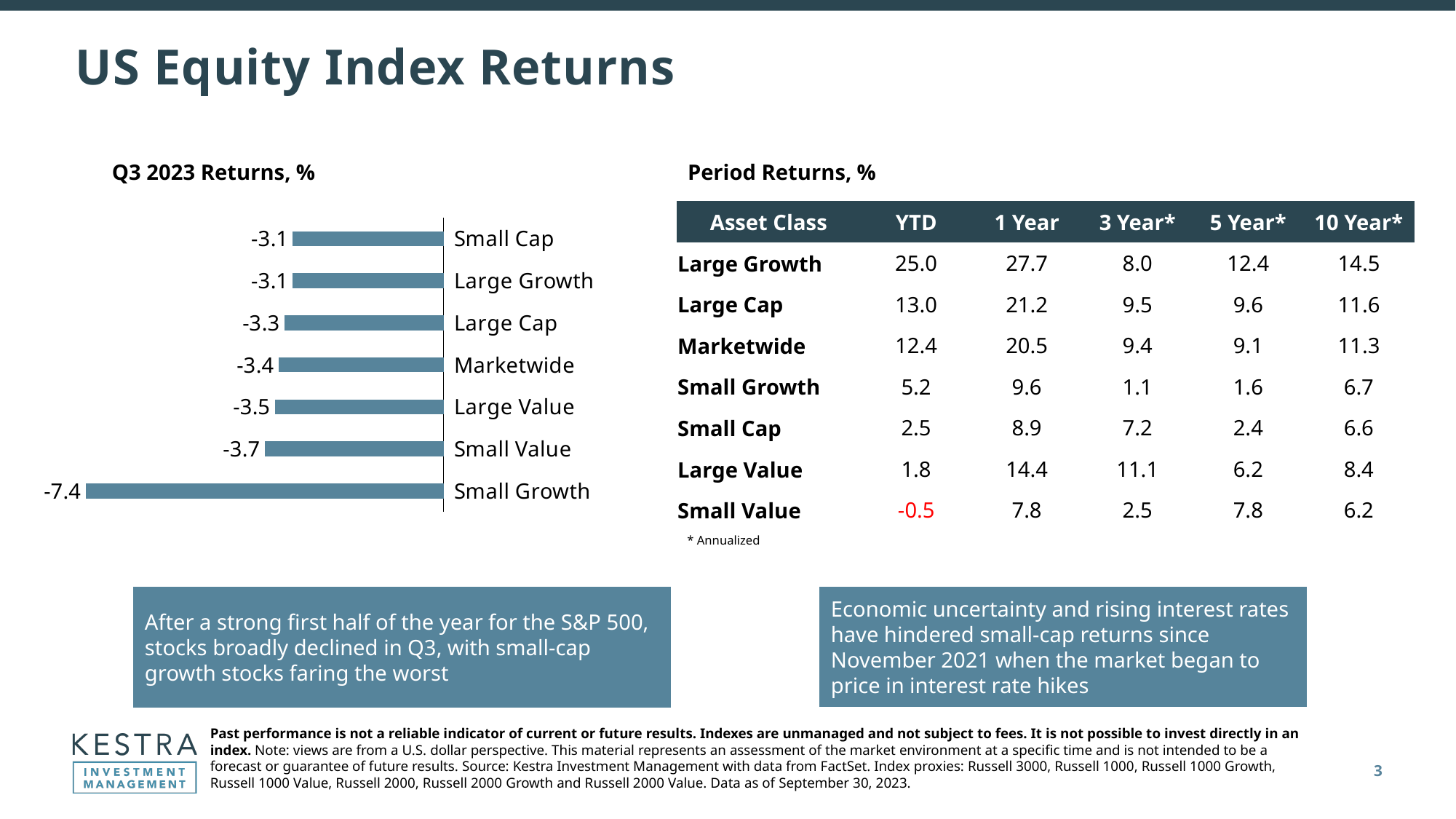
In the Q3 2023 Returns chart, what is the value for Large Value? -3.5 In the Q3 2023 Returns chart, what is the value for Marketwide? -3.4 In the Q3 2023 Returns chart, what is the value for Large Cap? -3.3 In the Q3 2023 Returns chart, what is the value for Small Growth? -7.4 What is the title of the chart on the left of the slide? Q3 2023 Returns, % In the Q3 2023 Returns chart, which category has the lowest value? Small Growth What kind of chart is the Q3 2023 Returns chart? Bar chart In the Q3 2023 Returns chart, which is larger, the value for Large Cap or the value for Small Growth? Large Cap How many categories are shown in the Q3 2023 Returns chart? 7 In the Q3 2023 Returns chart, what is the difference between the values for Small Value and Small Growth? 3.7 In the Q3 2023 Returns chart, what is the value for Small Value? -3.7 In the Q3 2023 Returns chart, what is the difference between the values for Small Cap and Large Value? 0.4